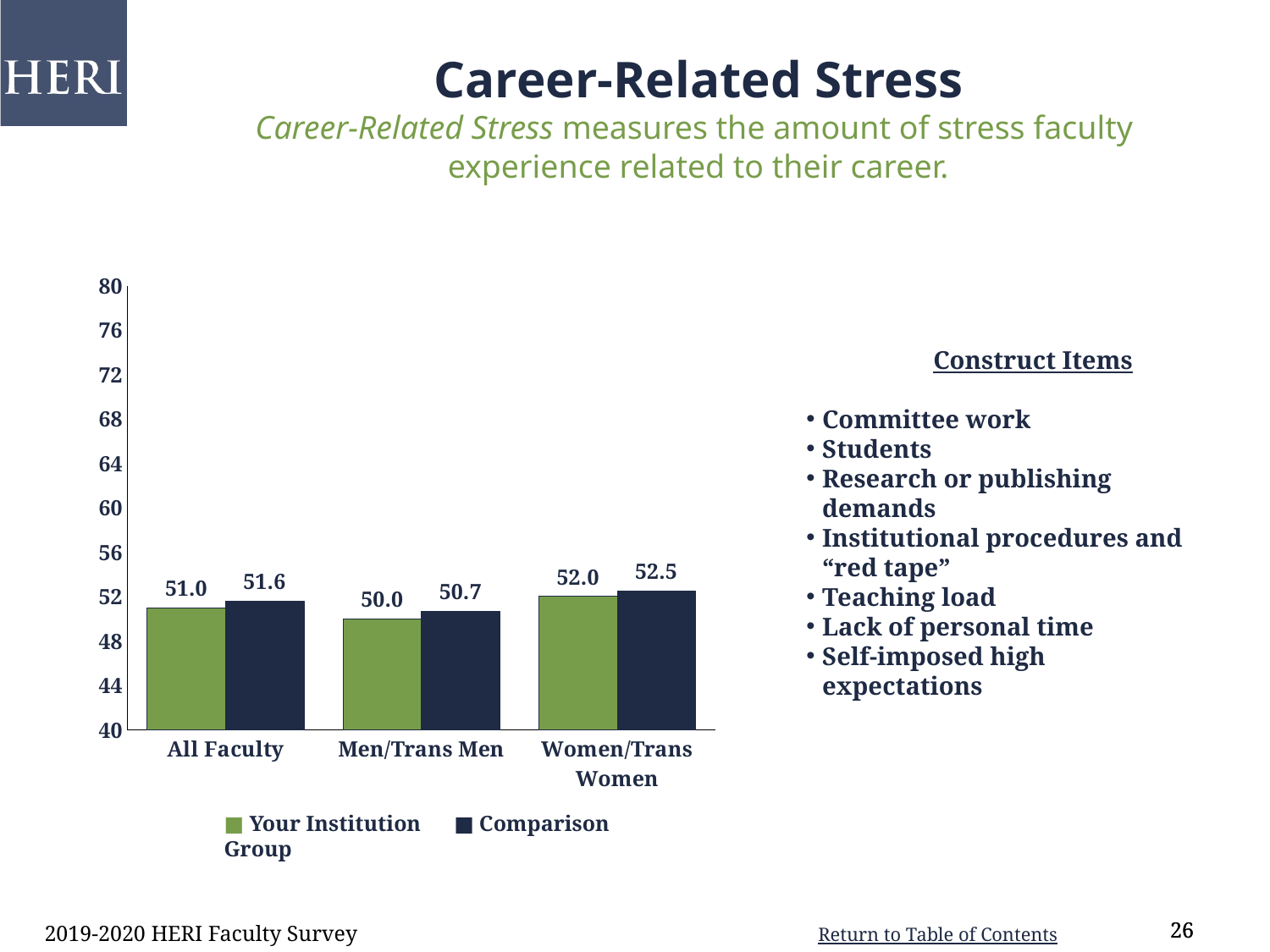
What is the Comparison Group value for Men/Trans Men? 50.7 What is the Comparison Group value for Women/Trans Women? 52.5 Which category has the highest Your Institution value? Women/Trans Women How many categories are shown on the x axis? 3 Which category has the lowest Comparison Group value? Men/Trans Men What is the Your Institution value for All Faculty? 51.0 How many series does the legend list? 2 What kind of chart is shown on the slide? Bar chart What is the difference between the Comparison Group and Your Institution values for All Faculty? 0.6 For Women/Trans Women, which is larger: Your Institution or Comparison Group? Comparison Group What colour are the Your Institution bars? Green What is the Your Institution value for Men/Trans Men? 50.0